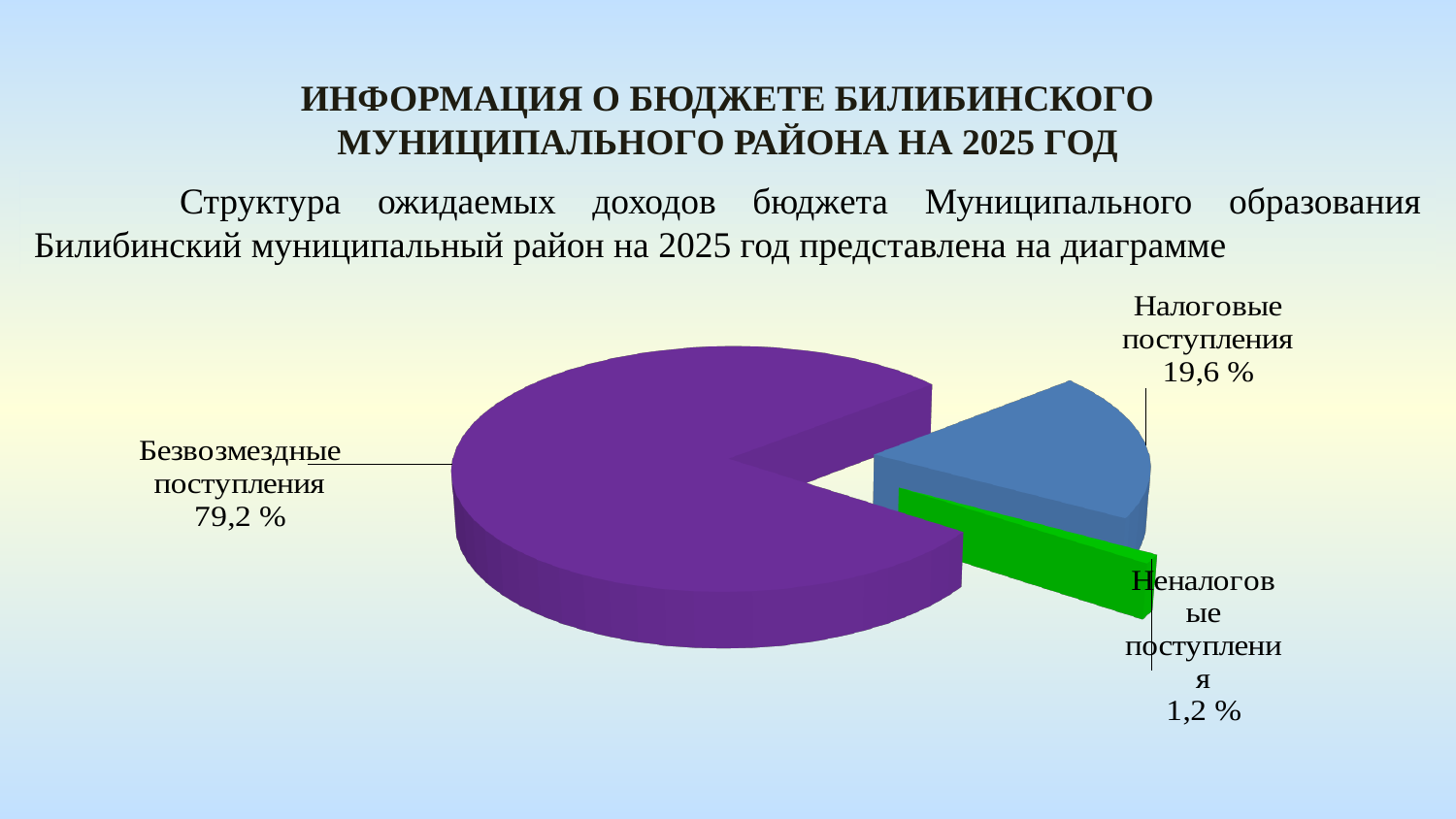
How many slices does the pie chart have? 3 Which category has the largest share of the pie? Безвозмездные поступления What colour is the slice for Безвозмездные поступления? Purple What share of the pie is Безвозмездные поступления? 79,2 % Which is larger: the share of Налоговые поступления or Неналоговые поступления? Налоговые поступления What colour is the slice for Неналоговые поступления? Green Which category has the smallest share of the pie? Неналоговые поступления What share of the pie is Неналоговые поступления? 1,2 % What kind of chart is shown on the slide? Pie chart What share of the pie is Налоговые поступления? 19,6 % What is the difference between the shares of Налоговые поступления and Неналоговые поступления? 18,4 % What is the difference between the shares of Безвозмездные поступления and Налоговые поступления? 59,6 %